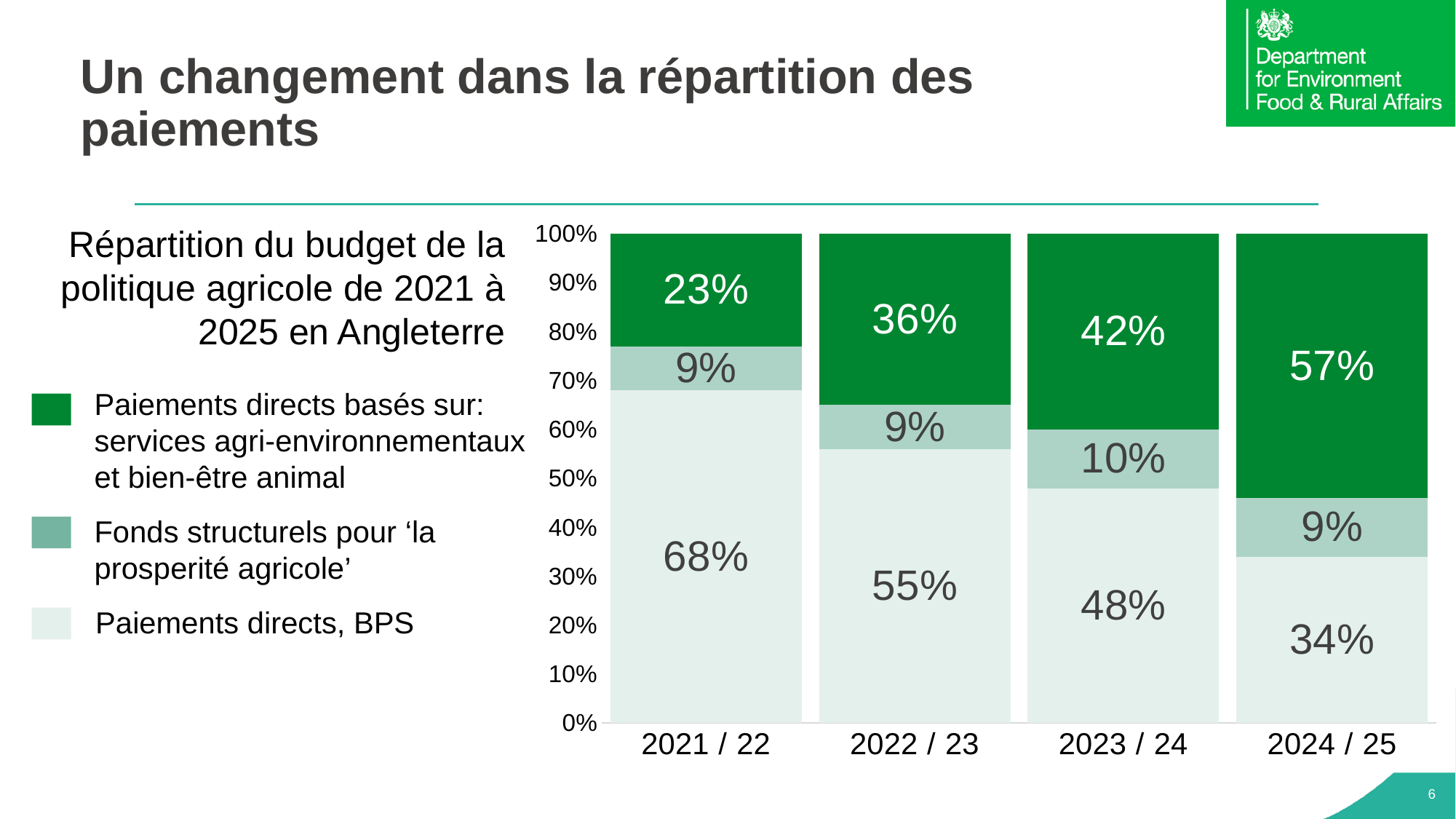
How many series does the legend list? 3 How many years are shown on the x axis of the chart? 4 What share of the budget goes to 'Paiements directs, BPS' in 2021 / 22? 68% What share of the budget goes to 'Fonds structurels pour la prosperité agricole' in 2023 / 24? 10% Does the share for 'Paiements directs, BPS' rise or fall from 2021 / 22 to 2024 / 25? Fall In which year is the share for 'Paiements directs, BPS' lowest? 2024 / 25 In which year is the share for 'Paiements directs basés sur: services agri-environnementaux et bien-être animal' highest? 2024 / 25 What is the difference between the 'Paiements directs, BPS' share in 2021 / 22 and in 2024 / 25? 34 percentage points Which is larger in 2022 / 23: the share for 'Paiements directs, BPS' or the share for agri-environmental direct payments? Paiements directs, BPS What share of the budget goes to 'Paiements directs basés sur: services agri-environnementaux et bien-être animal' in 2024 / 25? 57% What kind of chart is shown on the slide? Stacked bar chart What is the title of the chart? Répartition du budget de la politique agricole de 2021 à 2025 en Angleterre